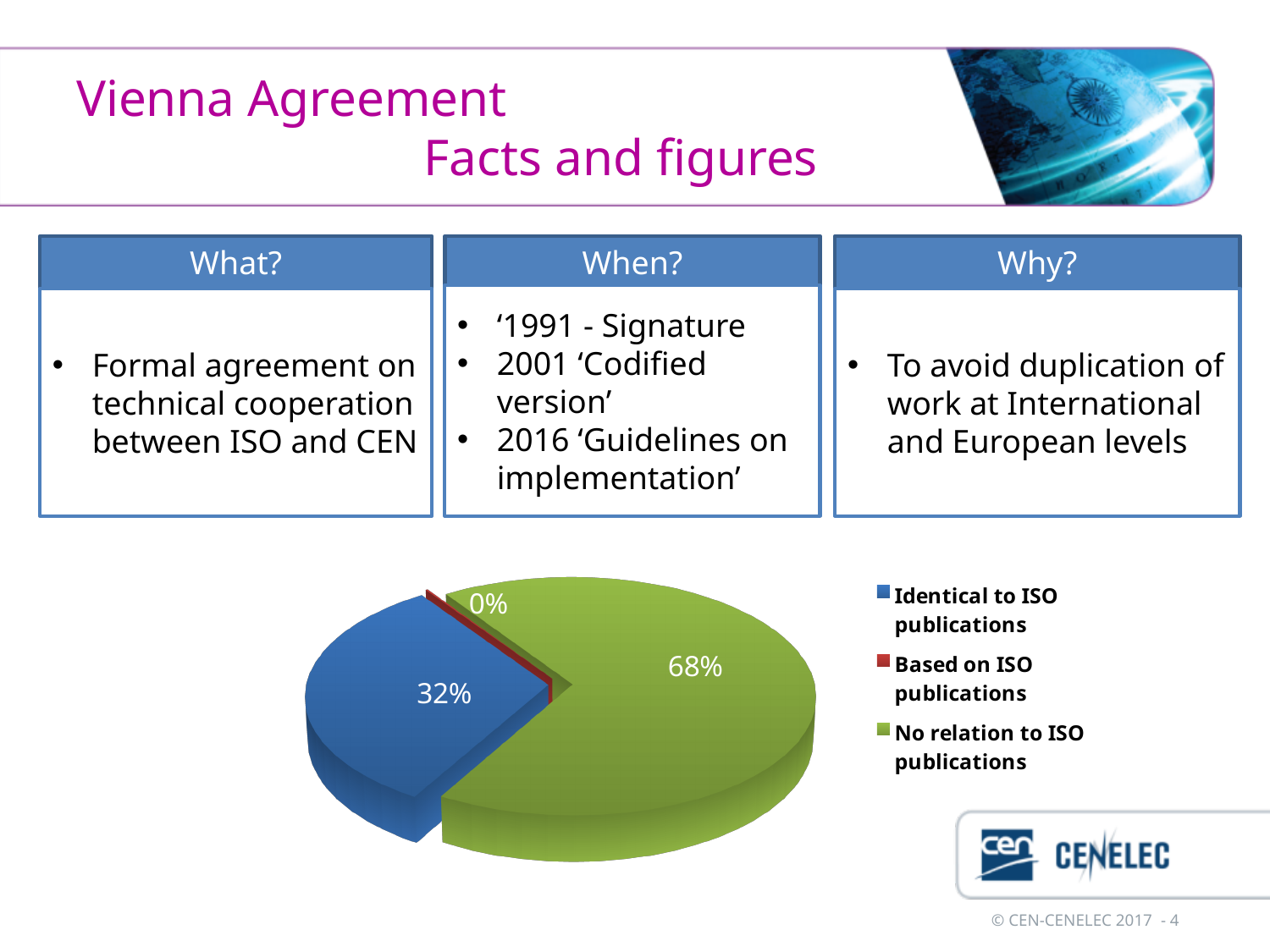
What colour is the 'No relation to ISO publications' slice in the pie chart? Green How many entries does the legend of the pie chart list? 3 What share of the pie chart is labelled 'Identical to ISO publications'? 32% How many categories does the pie chart show? 3 What kind of chart is shown on the slide? Pie chart What share of the pie chart is labelled 'No relation to ISO publications'? 68% What colour is the 'Identical to ISO publications' slice in the pie chart? Blue Which category has the largest slice in the pie chart? No relation to ISO publications Which category has the smallest slice in the pie chart? Based on ISO publications Which slice is larger: 'Identical to ISO publications' or 'No relation to ISO publications'? No relation to ISO publications What is the difference in percentage points between the 'No relation to ISO publications' slice and the 'Identical to ISO publications' slice? 36 percentage points What share of the pie chart is labelled 'Based on ISO publications'? 0%